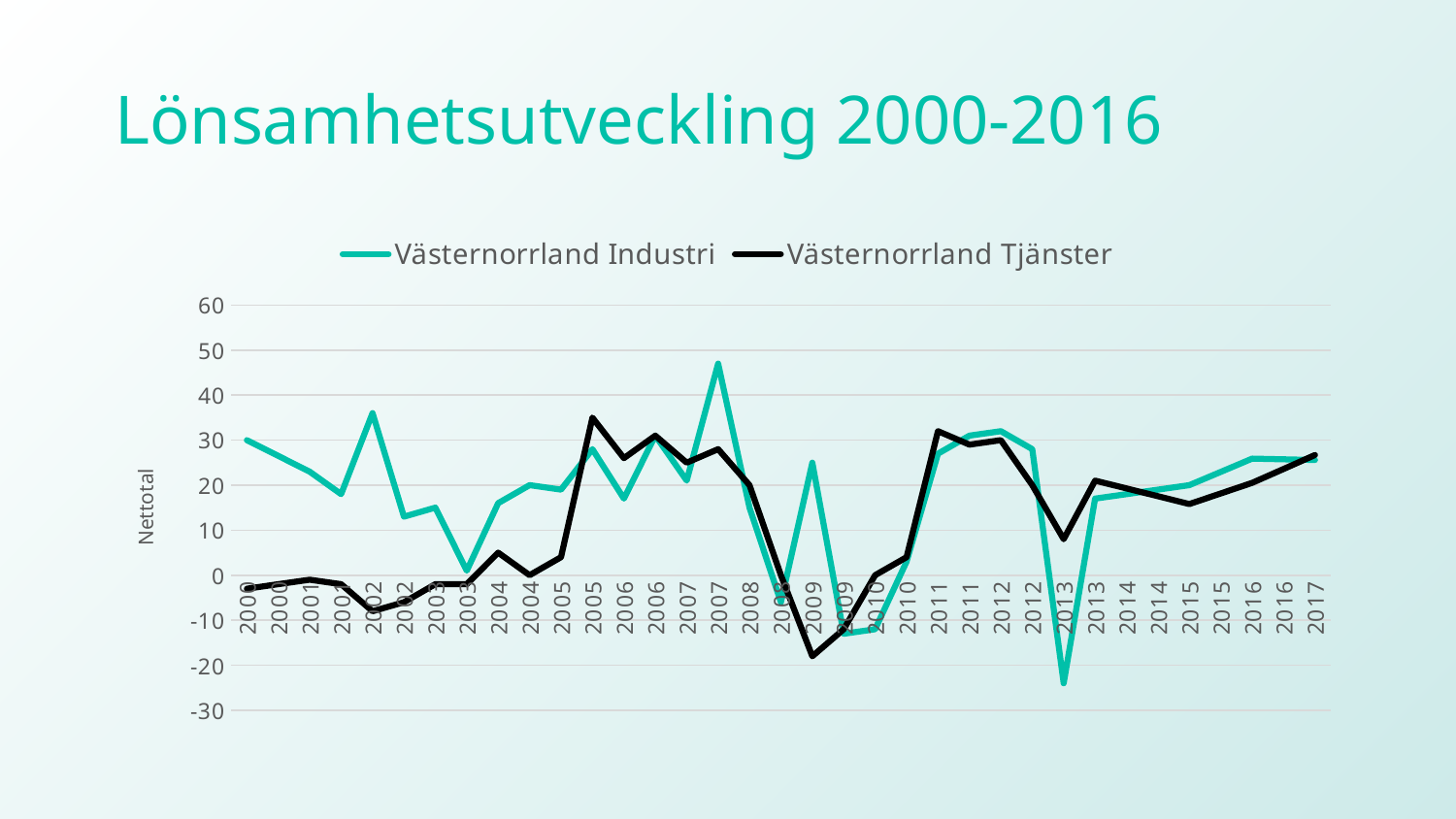
Which series reaches the highest value anywhere on the chart? Västernorrland Industri Is the value of Västernorrland Industri at the first 2013 point greater or less than -20? less What is the label on the vertical axis? Nettotal Is the value of Västernorrland Industri at the first 2002 point greater or less than 30? greater How many series does the legend list? 2 Is the peak value of Västernorrland Industri at the second 2007 point greater or less than 40? greater What is the title of the chart on the slide? Lönsamhetsutveckling 2000-2016 At the first 2013 point, which series has the higher value, Västernorrland Industri or Västernorrland Tjänster? Västernorrland Tjänster At the second 2007 point, which series has the higher value, Västernorrland Industri or Västernorrland Tjänster? Västernorrland Industri What kind of chart is shown on the slide? line chart